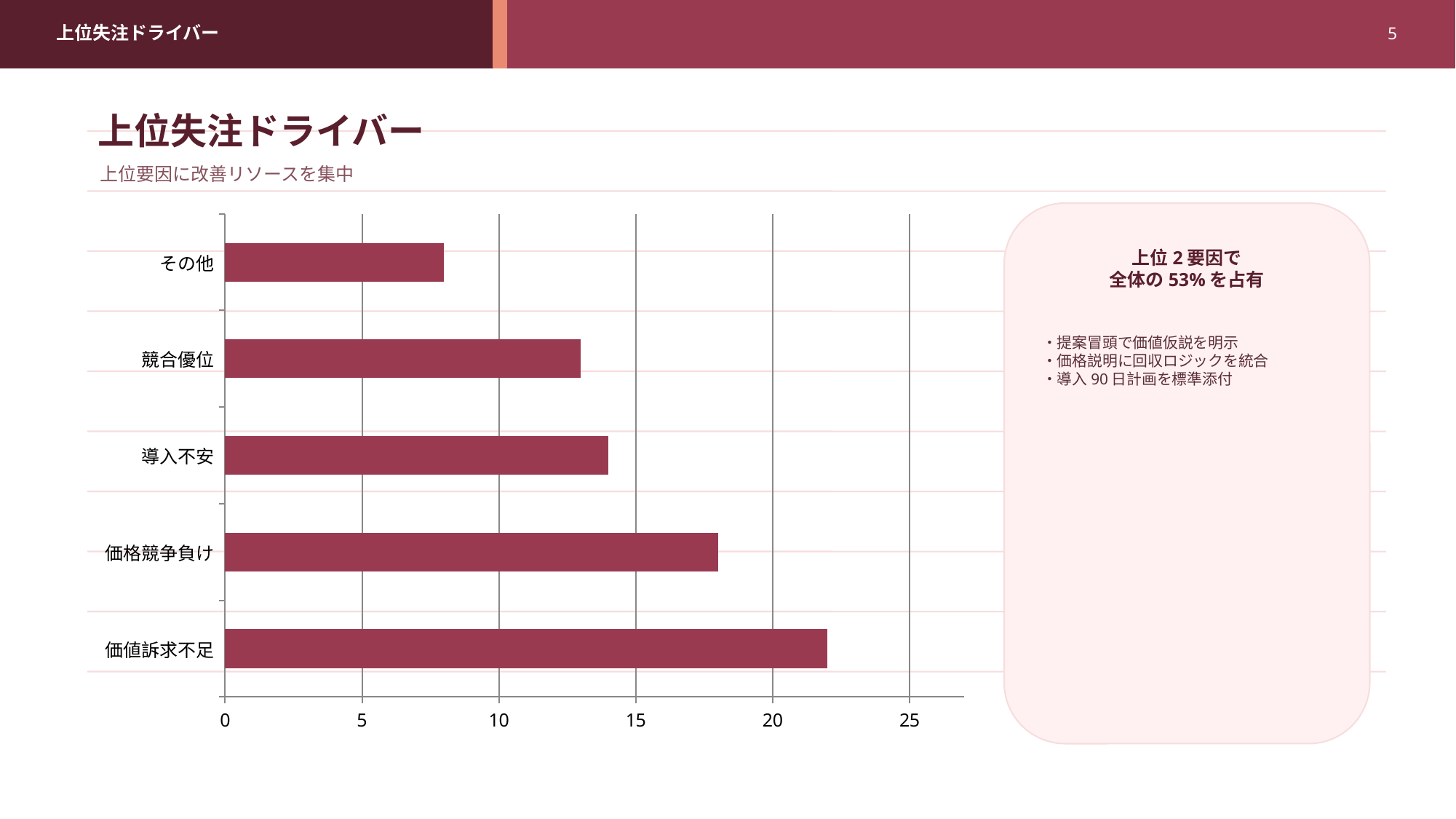
Which category has the lowest value in the chart? その他 Is the value for 価格競争負け greater or less than 15? greater How many categories are plotted in the chart? 5 Which is larger, the value for その他 or the value for 競合優位? 競合優位 Is the value for 競合優位 greater or less than 10? greater Which is larger, the value for 価格競争負け or the value for 導入不安? 価格競争負け What kind of chart is shown on the slide? bar chart What is the title of the slide containing the chart? 上位失注ドライバー Which category has the highest value in the chart? 価値訴求不足 Is the value for その他 greater or less than 10? less